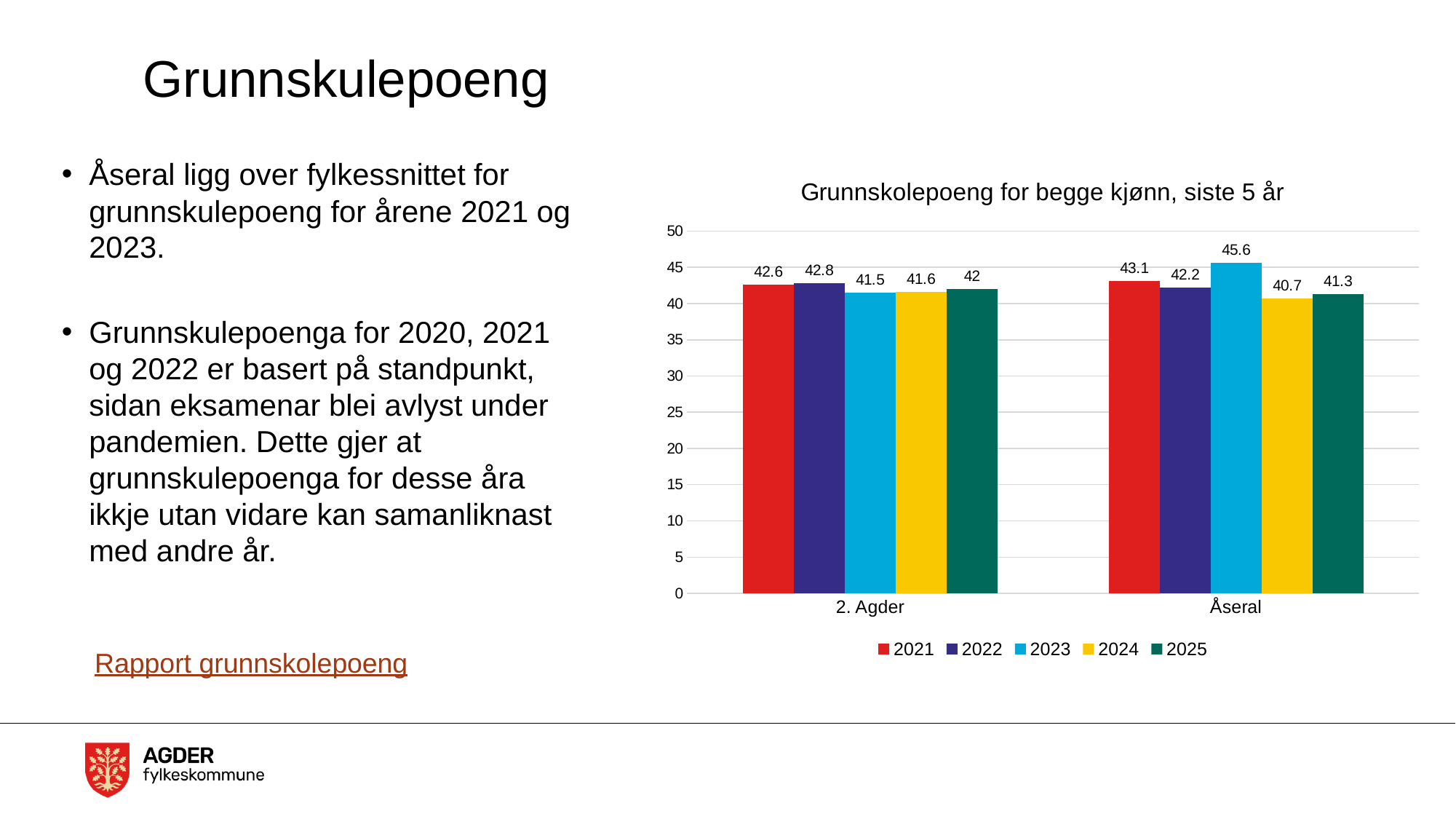
Which is larger in 2024, 2. Agder or Åseral? 2. Agder What is the value for Åseral in 2024? 40.7 What kind of chart is shown? Bar chart What is the title of the chart? Grunnskolepoeng for begge kjønn, siste 5 år What is the value for 2. Agder in 2021? 42.6 Which year has the lowest value for Åseral? 2024 What is the value for Åseral in 2023? 45.6 How many series does the legend list? 5 How many categories are shown on the x axis? 2 What is the difference between Åseral and 2. Agder in 2023? 4.1 What is the value for 2. Agder in 2025? 42 Which year has the highest value for Åseral? 2023